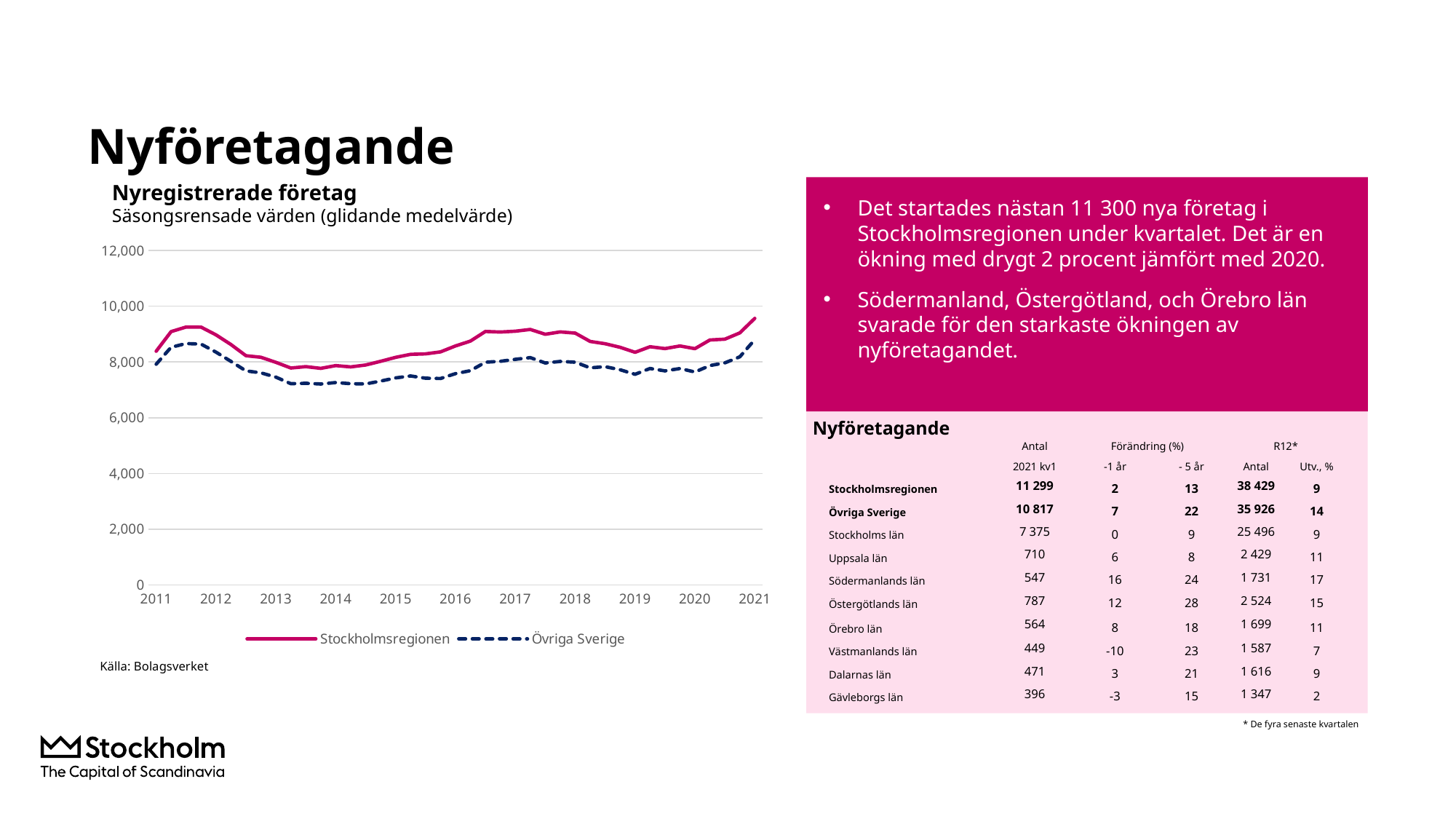
What kind of chart is shown on the slide? Line chart Is the value for Övriga Sverige in 2021 greater or less than 8,000? greater Does the Stockholmsregionen line rise or fall between 2012 and 2013? Fall What is the title of the chart? Nyregistrerade företag How many series does the chart legend list? 2 Which two series are shown in the chart legend? Stockholmsregionen and Övriga Sverige Does the Stockholmsregionen line rise or fall between 2019 and 2021? Rise How many year labels are shown on the x axis of the chart? 11 Is the value for Övriga Sverige in 2013 greater or less than 8,000? less Is the value for Stockholmsregionen in 2021 greater or less than 8,000? greater Which series has the higher value in 2021, Stockholmsregionen or Övriga Sverige? Stockholmsregionen